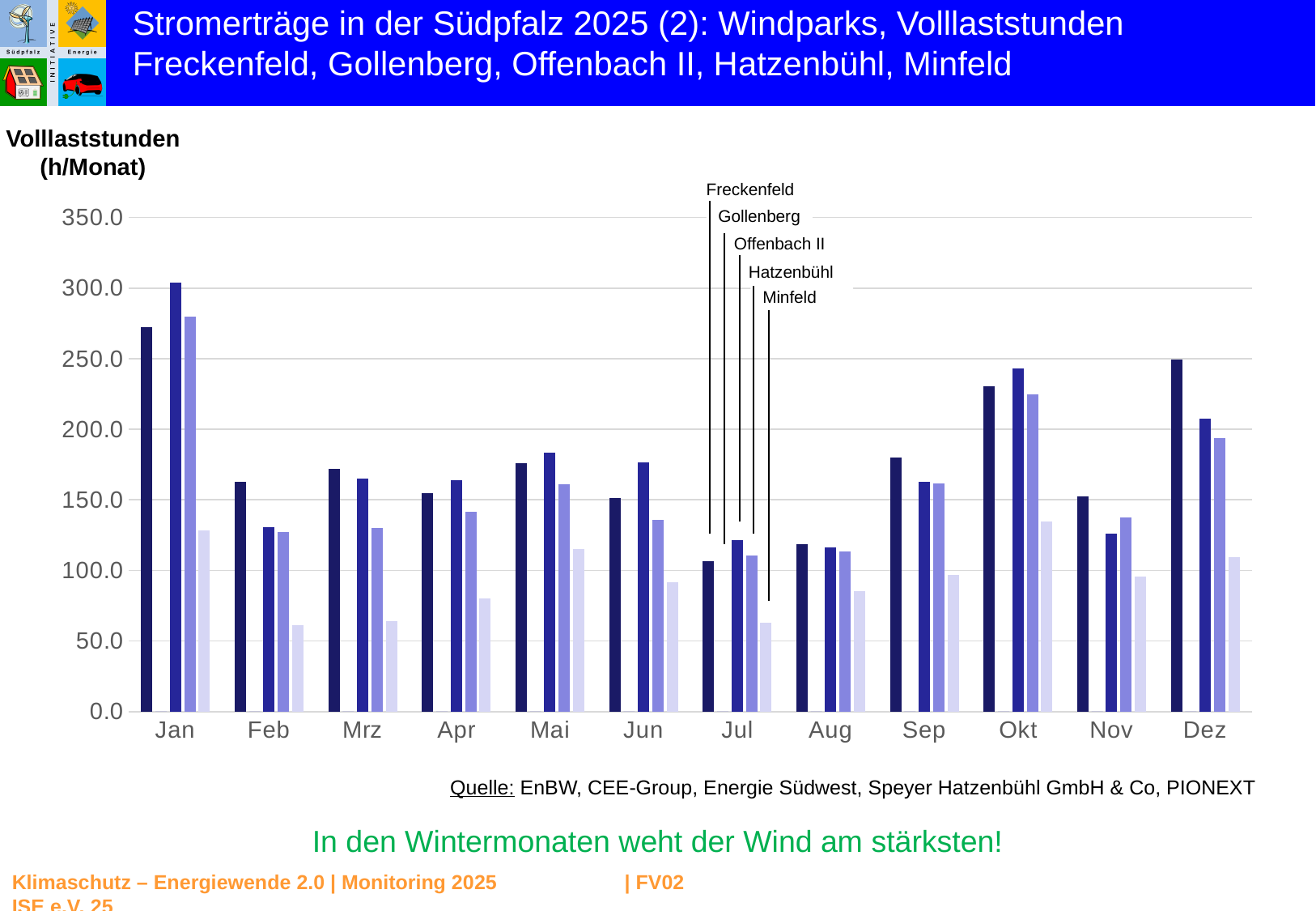
Which is larger, the Minfeld value for Okt or the Minfeld value for Sep? Okt Is the Freckenfeld value for Okt greater or less than 200? greater How many months are shown along the x axis of the chart? 12 Is the Freckenfeld value for Jan greater or less than 250? greater Is the Minfeld value for Jul greater or less than 100? less What unit is given for the y axis of the chart? h/Monat What kind of chart is shown on the slide? bar chart How many wind parks are named as series in the chart's labels? 5 In which month is the Freckenfeld value lowest? Jul In which month is the Freckenfeld value highest? Jan